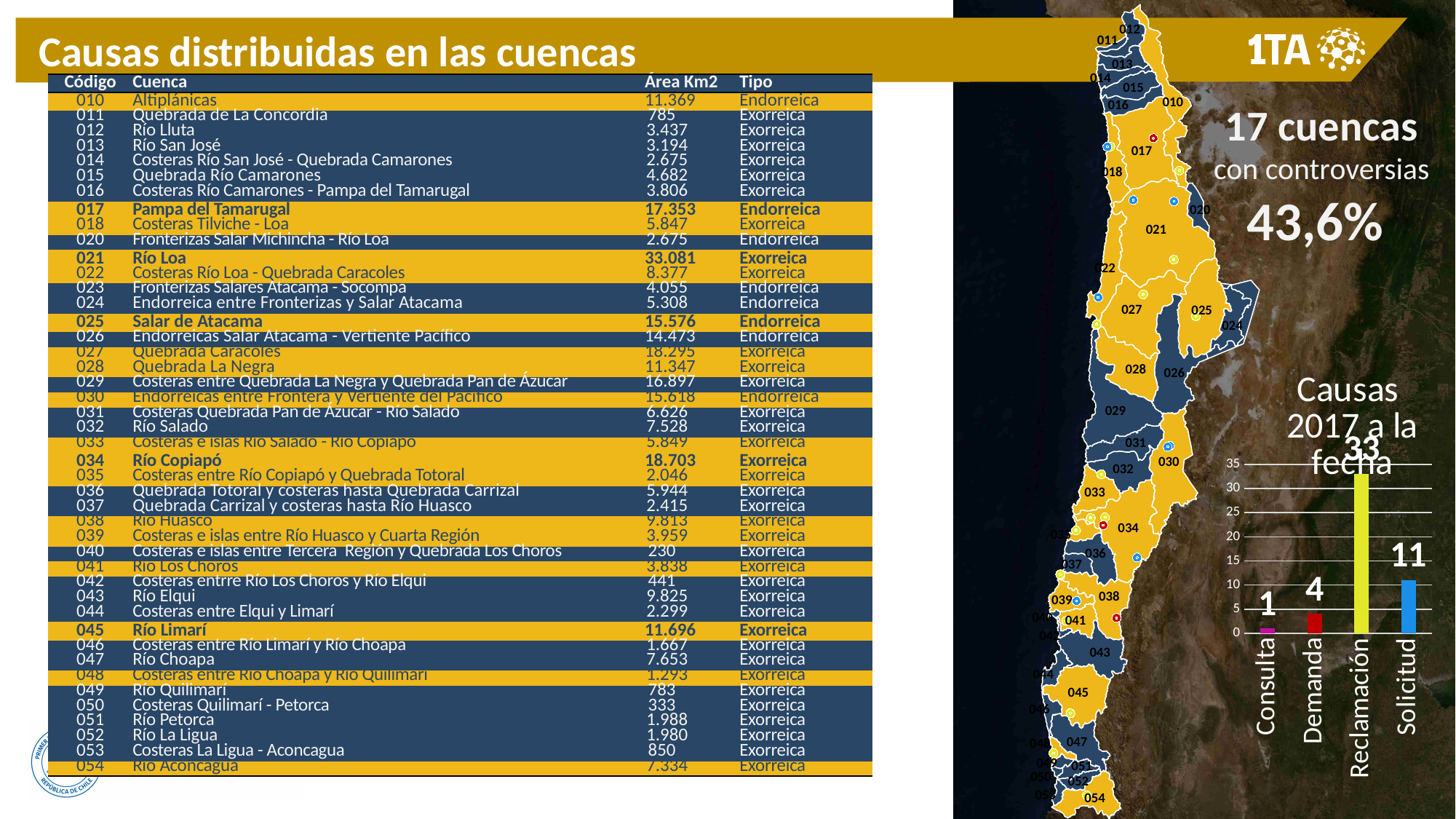
In the 'Causas 2017 a la fecha' chart, what is the value for Reclamación? 33 In the 'Causas 2017 a la fecha' chart, is the value for Reclamación greater or less than 30? greater In the 'Causas 2017 a la fecha' chart, what is the value for Consulta? 1 In the 'Causas 2017 a la fecha' chart, what is the total of all four categories? 49 In the 'Causas 2017 a la fecha' chart, what is the value for Solicitud? 11 How many categories are shown in the 'Causas 2017 a la fecha' chart? 4 In the 'Causas 2017 a la fecha' chart, what is the difference between the values for Reclamación and Solicitud? 22 In the 'Causas 2017 a la fecha' chart, what is the value for Demanda? 4 In the 'Causas 2017 a la fecha' chart, which category has the lowest value? Consulta What kind of chart is the 'Causas 2017 a la fecha' chart? bar chart In the 'Causas 2017 a la fecha' chart, which is larger, Demanda or Solicitud? Solicitud In the 'Causas 2017 a la fecha' chart, which category has the highest value? Reclamación